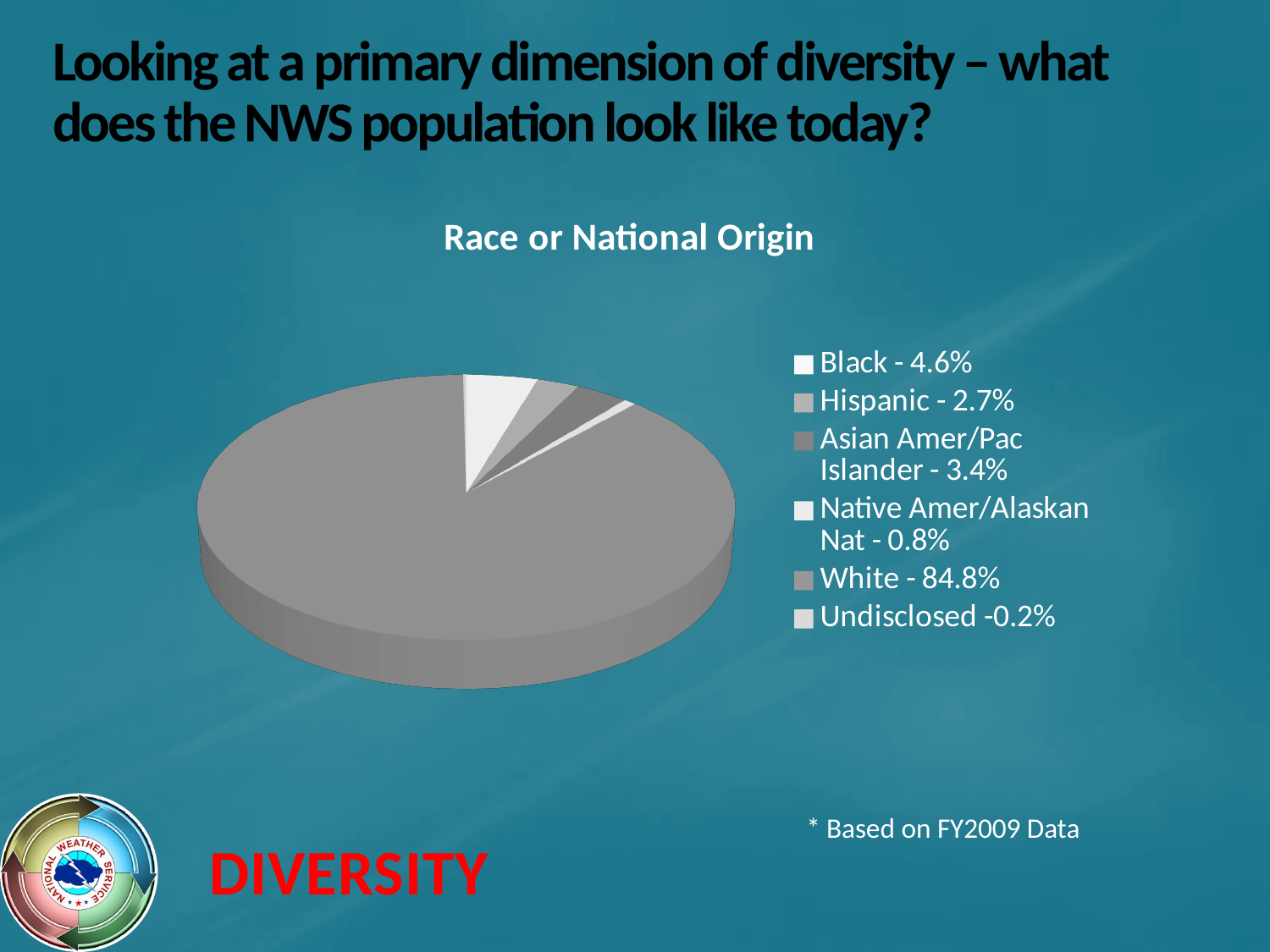
What percentage is shown for Black in the chart legend? 4.6% How many categories does the legend list? 6 What percentage is shown for Asian Amer/Pac Islander? 3.4% What is the title of the chart? Race or National Origin Which is larger, the share for Black or the share for Asian Amer/Pac Islander? Black Which category has the largest share of the pie? White What percentage of the NWS population is White according to the chart? 84.8% What type of chart is shown on the slide? Pie chart What percentage is shown for Native Amer/Alaskan Nat? 0.8% What is the difference in percentage points between the Black share and the Hispanic share? 1.9 What percentage is shown for Hispanic? 2.7% Which category has the smallest share of the pie? Undisclosed